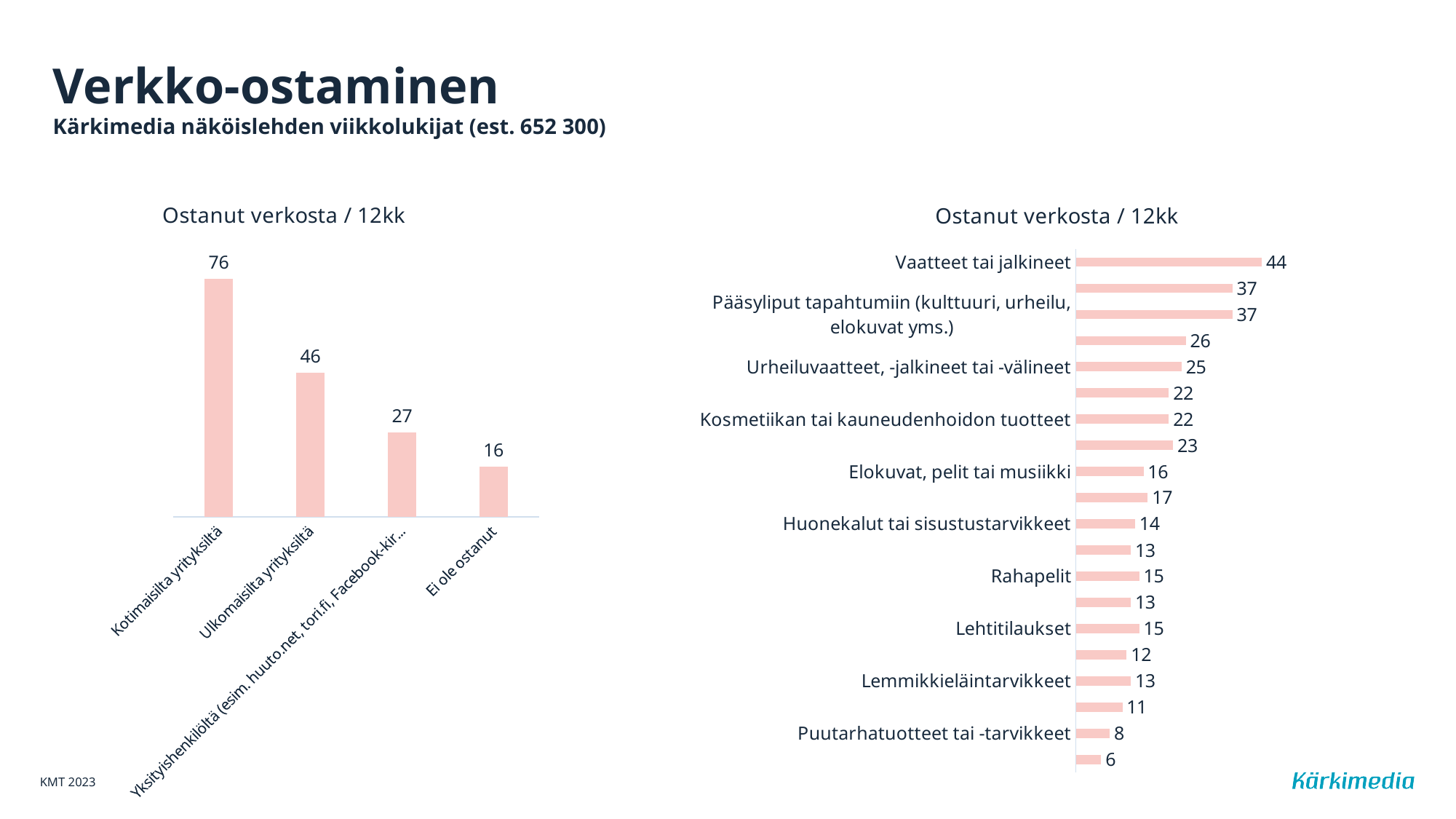
What kind of chart is the left chart? Bar chart In the left chart, which category has the lowest value? Ei ole ostanut In the right chart, which is larger: Urheiluvaatteet, -jalkineet tai -välineet or Elokuvat, pelit tai musiikki? Urheiluvaatteet, -jalkineet tai -välineet In the left chart, which category has the highest value? Kotimaisilta yrityksiltä In the right chart, what is the value for Vaatteet tai jalkineet? 44 What is the title of the right chart? Ostanut verkosta / 12kk In the left chart, what is the difference between Kotimaisilta yrityksiltä and Ulkomaisilta yrityksiltä? 30 In the right chart, what is the value for Puutarhatuotteet tai -tarvikkeet? 8 How many categories are shown in the left chart? 4 In the left chart, what is the value for Ei ole ostanut? 16 In the left chart, what is the value for Ulkomaisilta yrityksiltä? 46 In the left chart, what is the value for Kotimaisilta yrityksiltä? 76